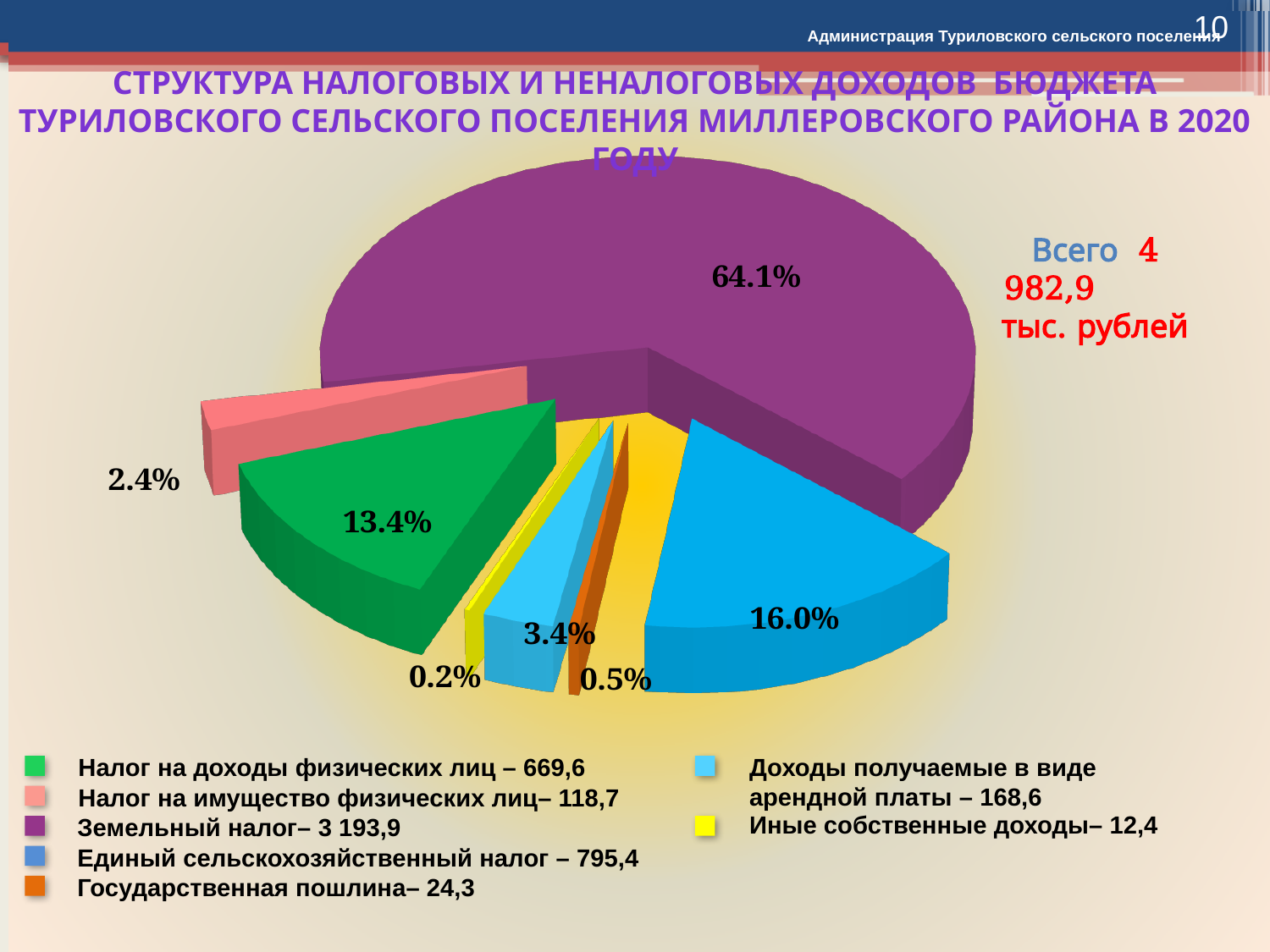
What share of the pie does Единый сельскохозяйственный налог (the blue slice) take? 16.0% What is the difference in percentage points between the Земельный налог slice (64.1%) and the Единый сельскохозяйственный налог slice (16.0%)? 48.1 Which category has the smallest slice of the pie? Иные собственные доходы What value does the legend give for Земельный налог? 3 193,9 What kind of chart is shown on the slide? pie chart What share of the pie does Налог на доходы физических лиц (the green slice) take? 13.4% What share of the pie does Земельный налог (the purple slice) take? 64.1% Which category has the largest slice of the pie? Земельный налог What total (Всего) is stated next to the pie chart? 4 982,9 тыс. рублей Which slice is larger: Налог на доходы физических лиц or Доходы получаемые в виде арендной платы? Налог на доходы физических лиц How many slices does the pie chart have? 7